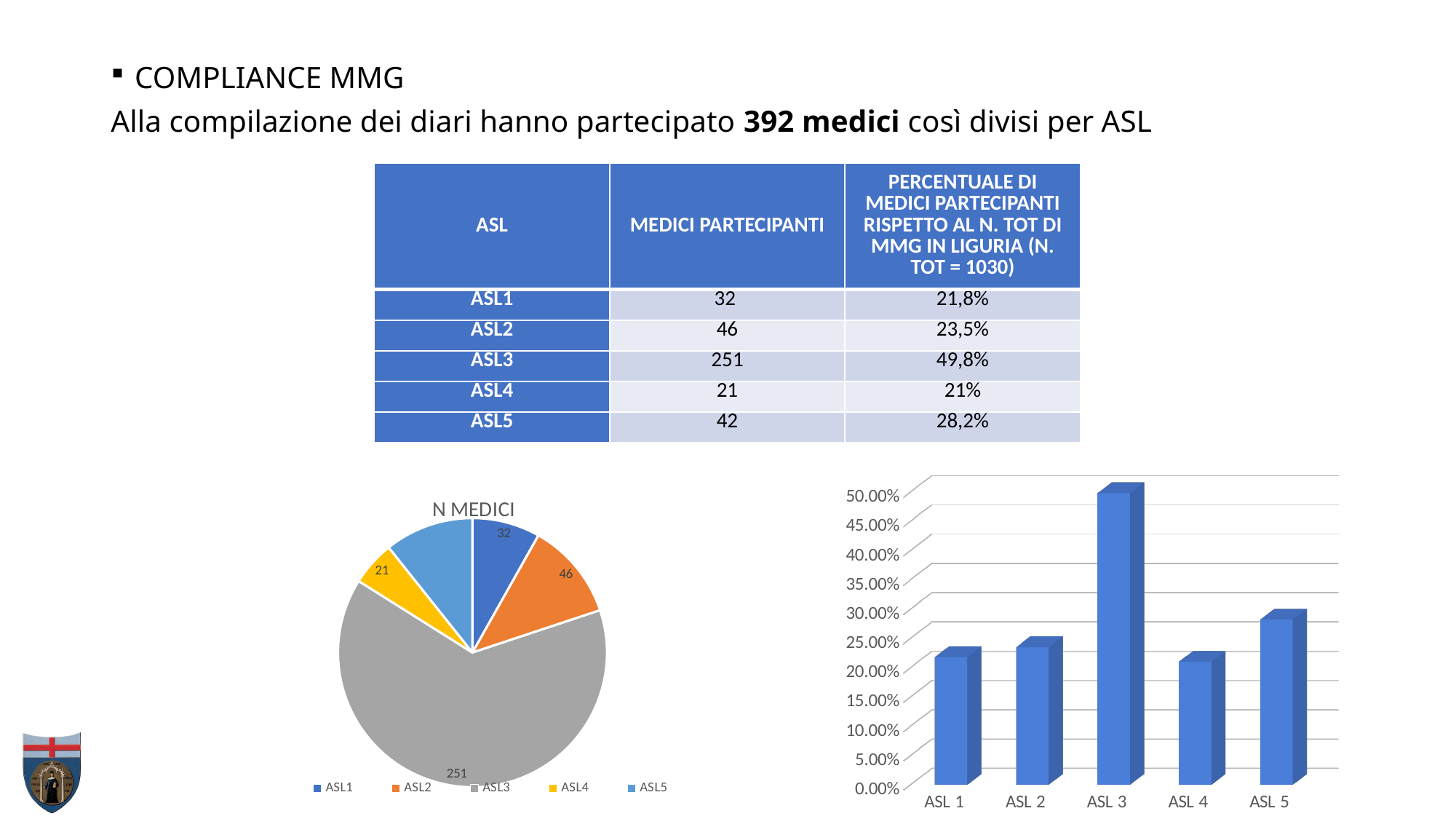
In the bar chart on the right of the slide, which ASL has the highest bar? ASL 3 What kind of chart is the chart titled N MEDICI on the left of the slide? pie chart In the N MEDICI pie chart, what value is shown for ASL4? 21 In the N MEDICI pie chart, what value is shown for ASL3? 251 In the bar chart on the right of the slide, is the value for ASL 4 greater or less than 25.00%? less In the N MEDICI pie chart, what is the difference between the values for ASL2 and ASL1? 14 In the bar chart on the right of the slide, is the value for ASL 3 greater or less than 45.00%? greater How many entries does the legend of the N MEDICI pie chart list? 5 What is the title of the pie chart on the left of the slide? N MEDICI In the N MEDICI pie chart, what value is shown for ASL2? 46 In the N MEDICI pie chart, which ASL has the largest slice? ASL3 What kind of chart is the chart on the right of the slide with ASL 1 to ASL 5 on the x axis? bar chart